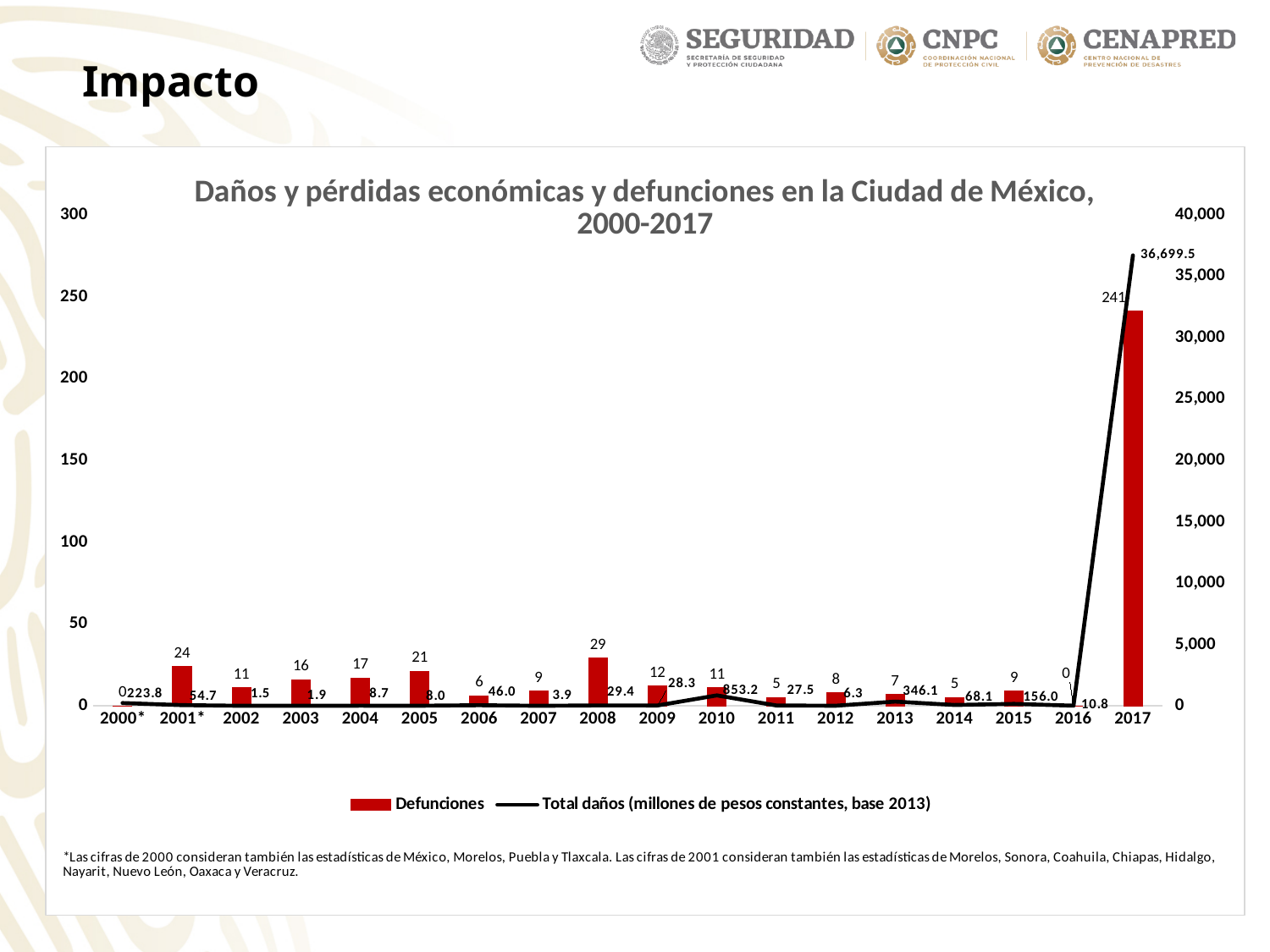
What is the difference in Defunciones between 2017 and 2001*? 217 How many Defunciones are shown for 2017? 241 How many years are shown on the x axis? 18 How many Defunciones are shown for 2001*? 24 Which year has the highest number of Defunciones? 2017 What kind of chart is this? Combined bar and line chart Which year has more Defunciones, 2004 or 2005? 2005 What is the Total daños value for 2015? 156.0 What is the Total daños value for 2017? 36,699.5 How many series does the legend list? 2 What is the Total daños value for 2010? 853.2 What is the value of Defunciones for 2008? 29